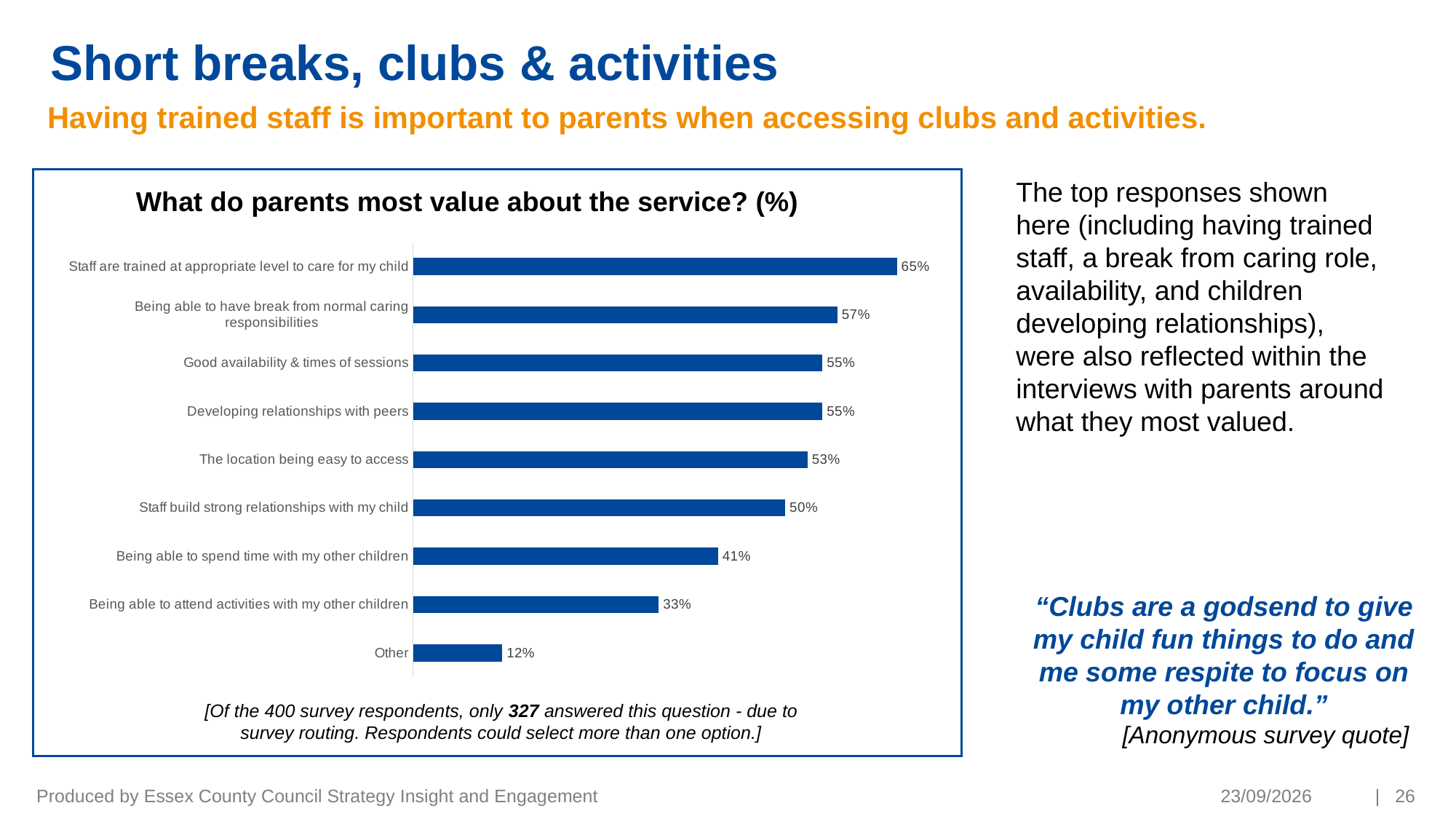
Which category has the lowest value in the chart? Other What is the value for 'Being able to have break from normal caring responsibilities'? 57% According to the note below the chart, how many of the 400 survey respondents answered this question? 327 What percentage of parents value that staff are trained at appropriate level to care for their child? 65% Which is larger: 'Being able to spend time with my other children' or 'Staff build strong relationships with my child'? Staff build strong relationships with my child How many categories are shown in the chart? 9 Which category has the highest value in the chart? Staff are trained at appropriate level to care for my child What is the title of the chart? What do parents most value about the service? (%) What kind of chart is shown on the slide? Bar chart What is the value for 'The location being easy to access'? 53% What is the value for 'Other'? 12% What is the difference between 'Staff are trained at appropriate level to care for my child' and 'Being able to attend activities with my other children'? 32 percentage points